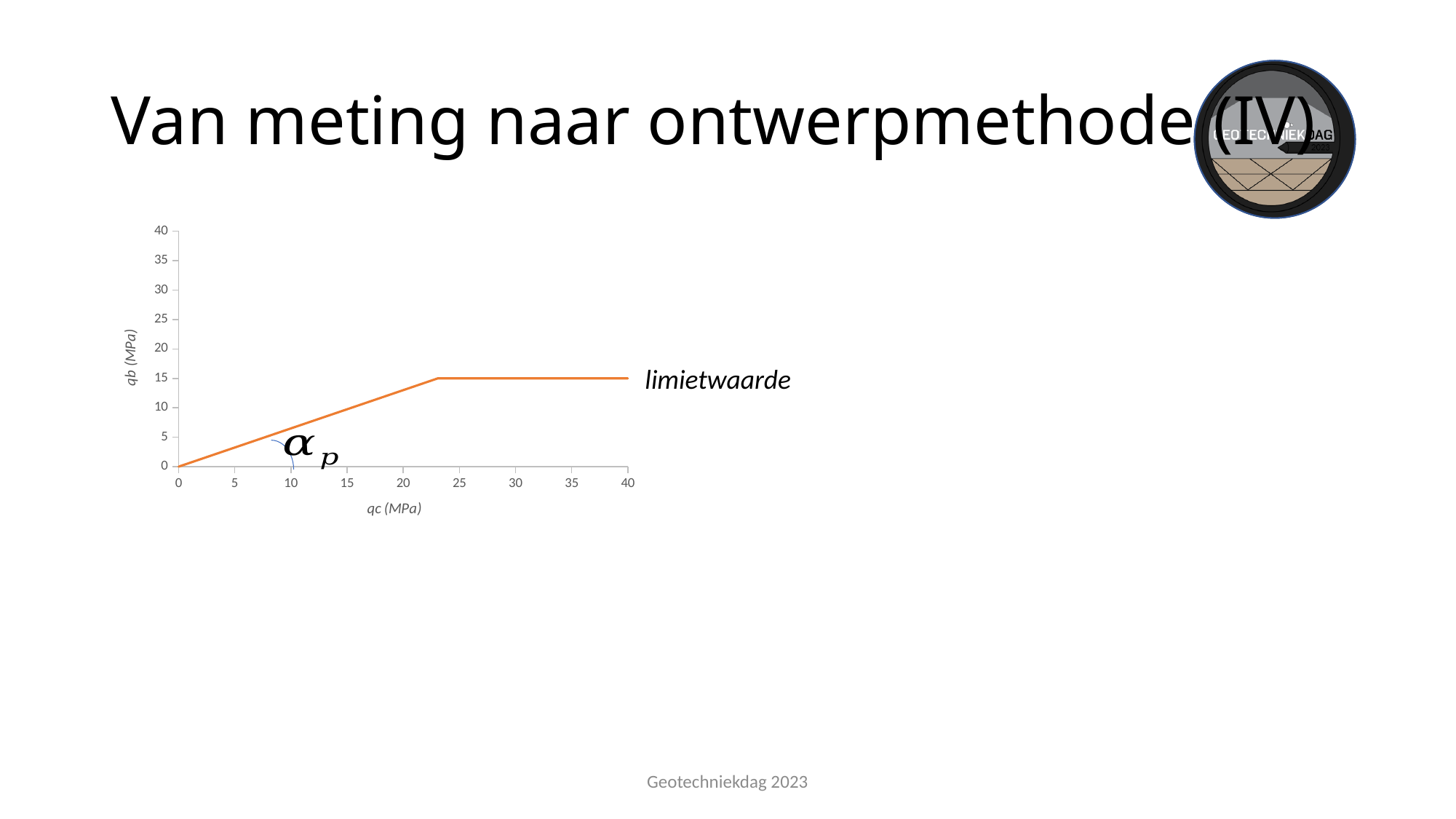
What is the label of the y axis of the chart? qb (MPa) What is the value of qb at qc = 0? 0 What value of qb does the line level off at for large qc? 15 Is the value of qb at qc = 10 greater or less than 10? less Is the value of qb at qc = 30 greater or less than 20? less Is the value of qb at qc = 10 greater or less than 5? greater Does qb rise, fall or stay flat as qc increases from 0 to 20? rise Does qb rise, fall or stay flat as qc increases from 25 to 40? stay flat What is the value of qb at qc = 40? 15 What is the label of the x axis of the chart? qc (MPa) What kind of chart is shown on the slide? line chart